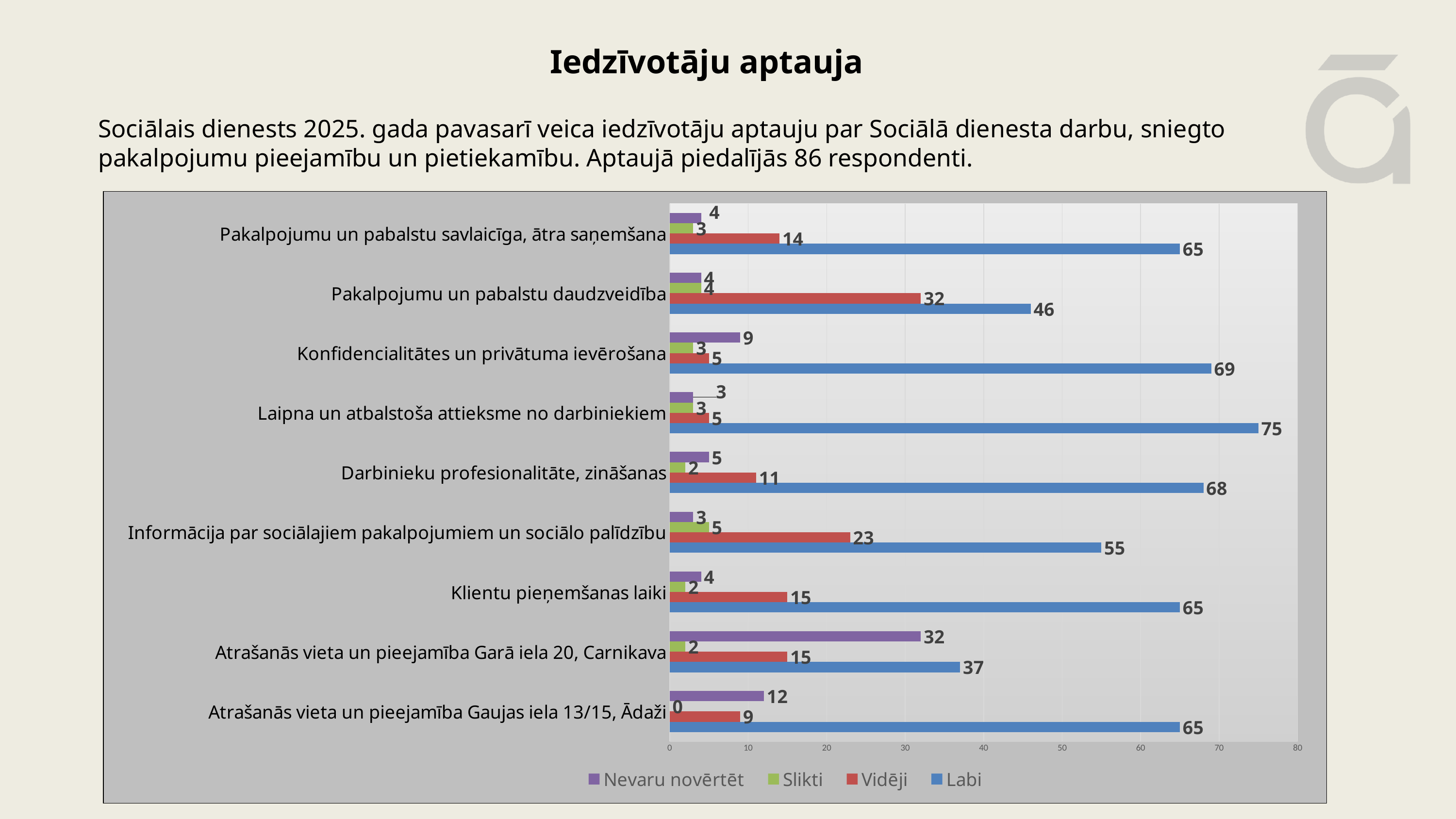
What is the value for "Nevaru novērtēt" for "Atrašanās vieta un pieejamība Garā iela 20, Carnikava"? 32 What is the difference between the "Labi" values for "Konfidencialitātes un privātuma ievērošana" and "Pakalpojumu un pabalstu daudzveidība"? 23 Which series is shown in blue in the legend? Labi What is the value for "Labi" for "Laipna un atbalstoša attieksme no darbiniekiem"? 75 How many series does the legend list? 4 Which is larger: the "Vidēji" value for "Informācija par sociālajiem pakalpojumiem un sociālo palīdzību" or for "Klientu pieņemšanas laiki"? Informācija par sociālajiem pakalpojumiem un sociālo palīdzību What is the value for "Vidēji" for "Pakalpojumu un pabalstu daudzveidība"? 32 Which category has the lowest value for "Labi"? Atrašanās vieta un pieejamība Garā iela 20, Carnikava What kind of chart is shown on the slide? Bar chart Which category has the highest value for "Labi"? Laipna un atbalstoša attieksme no darbiniekiem What is the value for "Slikti" for "Atrašanās vieta un pieejamība Gaujas iela 13/15, Ādaži"? 0 How many categories are shown on the chart? 9